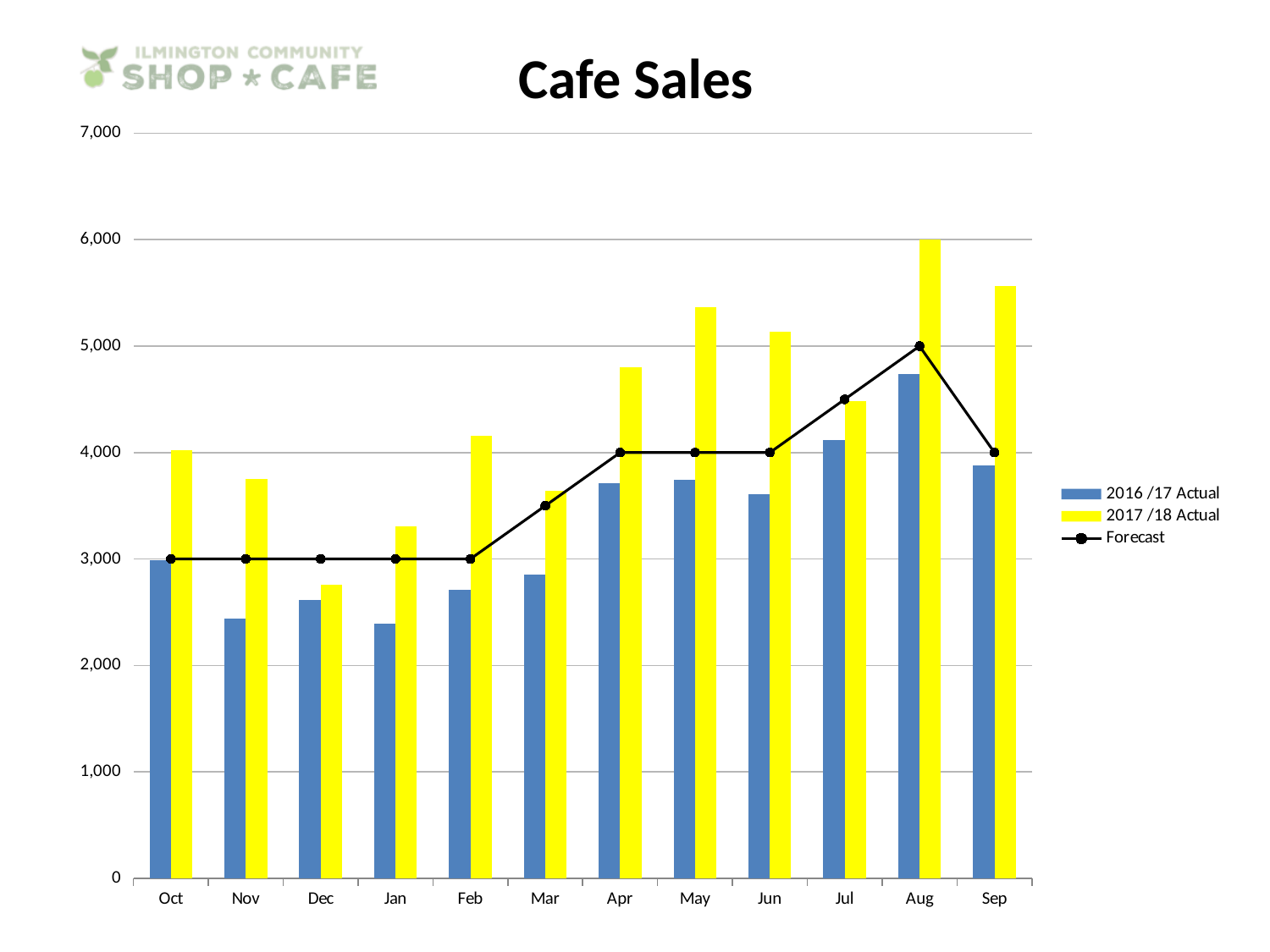
Is the 2016 /17 Actual value for Jun greater or less than 4,000? less What is the title of the chart? Cafe Sales Does the Forecast line rise or fall from Aug to Sep? fall What is the Forecast value for Aug? 5,000 Which month has the highest 2016 /17 Actual value? Aug How many series does the legend list? 3 What kind of chart is shown on the slide? Bar chart with a line series Is the 2017 /18 Actual value for May greater or less than 5,000? greater Which month has the lowest 2017 /18 Actual value? Dec Which month has the highest 2017 /18 Actual value? Aug What is the Forecast value for Oct? 3,000 How many months are shown along the x axis? 12